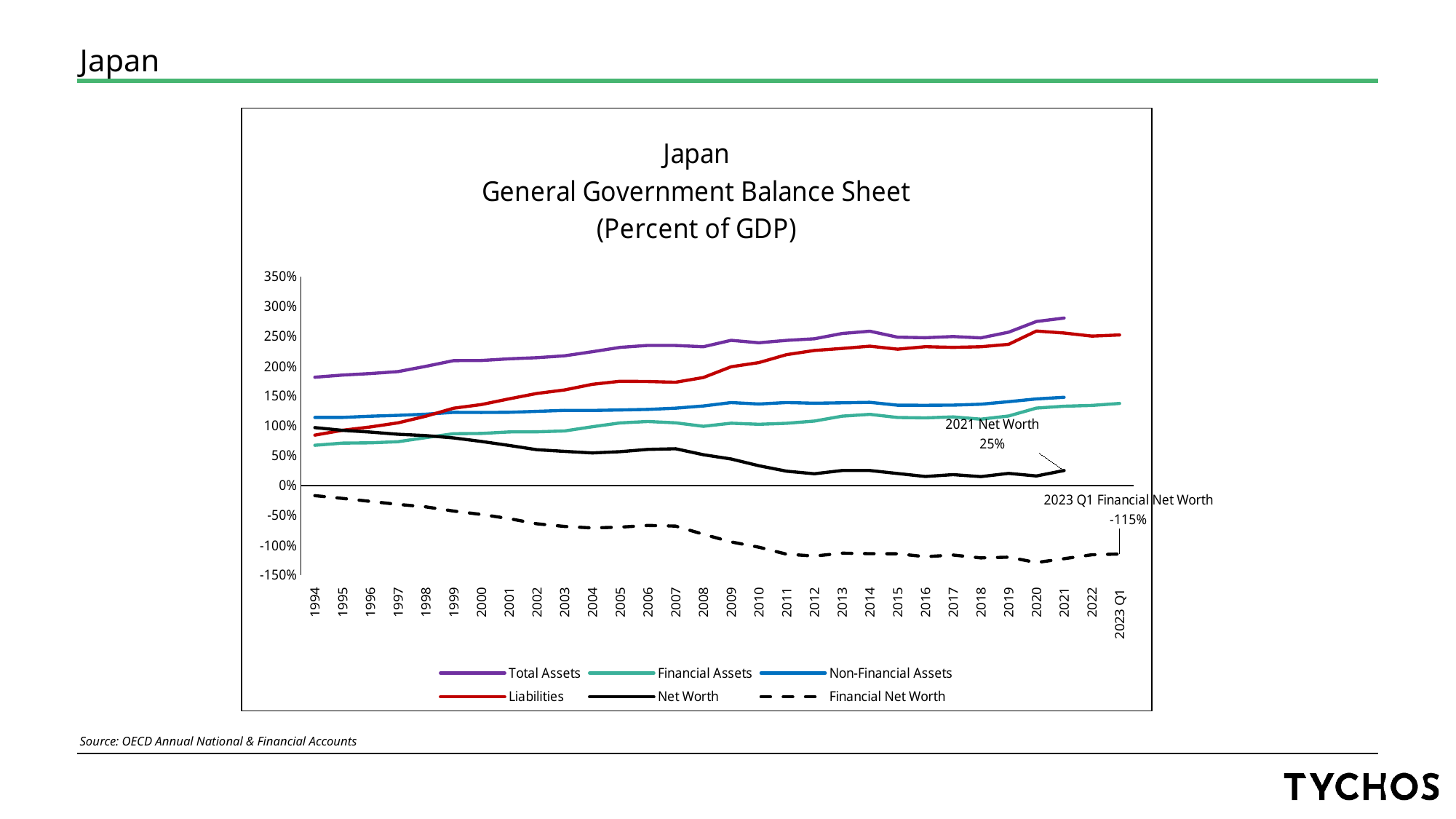
Is the Total Assets value for 2021 greater or less than 250%? greater What is the Net Worth value for 2021 according to the annotation? 25% What kind of chart is shown on the slide? line chart How many series does the legend list? 6 Does the Liabilities line generally rise or fall from 1994 to 2023 Q1? rise What is the Financial Net Worth value for 2023 Q1 according to the annotation? -115% Which series is drawn as a dashed line? Financial Net Worth Does the Net Worth line generally rise or fall from 1994 to 2021? fall In 2021, which is larger: Total Assets or Liabilities? Total Assets Is the Liabilities value for 1994 greater or less than 100%? less Which series has the highest values across the chart? Total Assets Is the Total Assets value for 1994 greater or less than 150%? greater